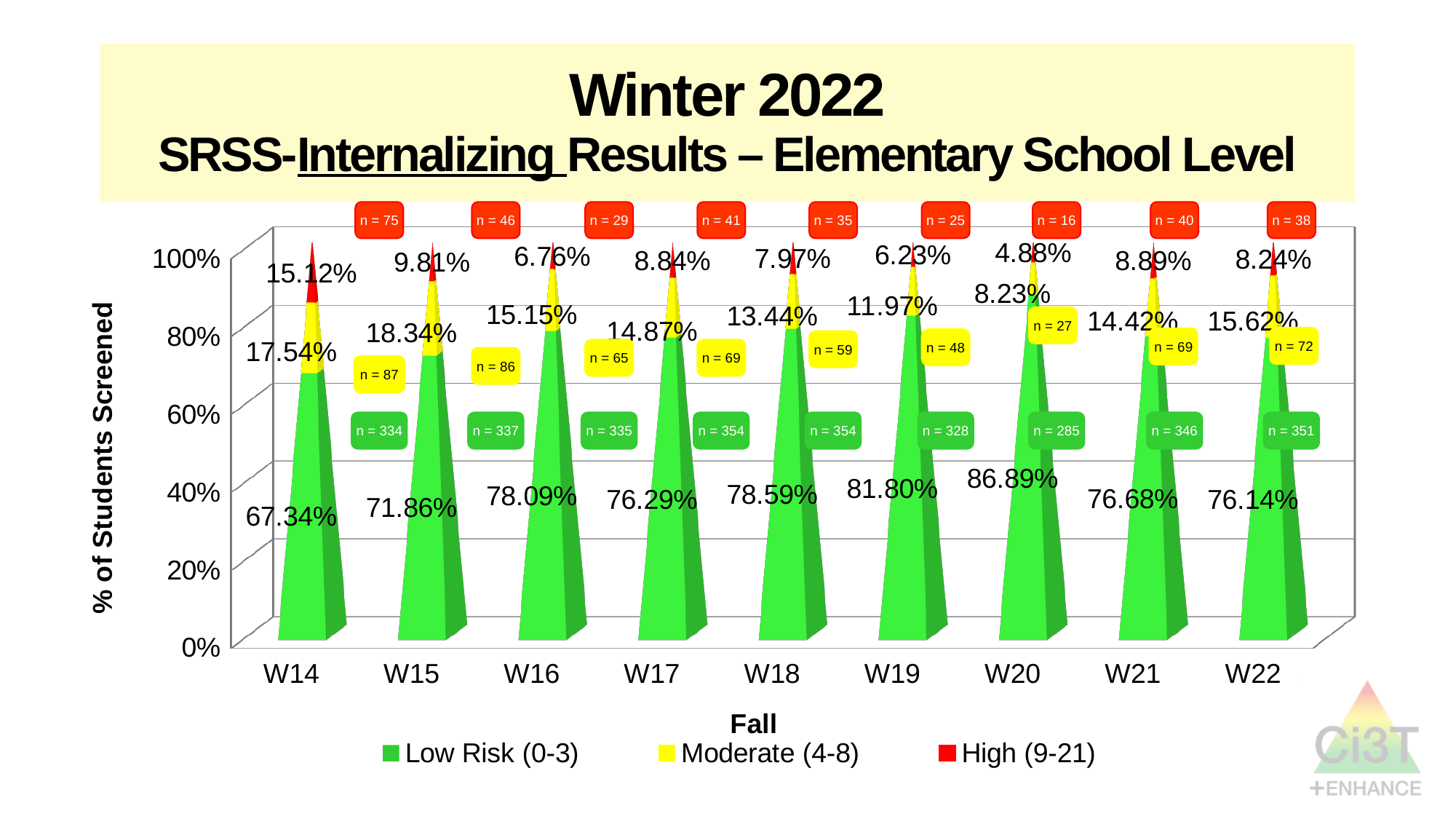
Which week has the lowest Low Risk (0-3) percentage? W14 Which week has the highest High (9-21) percentage? W14 How many weeks are shown on the x axis? 9 What is the Low Risk (0-3) percentage for W20? 86.89% Which week has the larger Moderate (4-8) percentage, W15 or W22? W15 What kind of chart is shown on the slide? Stacked bar chart What is the High (9-21) percentage for W14? 15.12% What is the Moderate (4-8) percentage for W18? 13.44% What is the difference between the Low Risk (0-3) percentages for W20 and W14? 19.55 percentage points Which week has the lowest High (9-21) percentage? W20 Which week has the highest Low Risk (0-3) percentage? W20 How many series does the legend list? 3